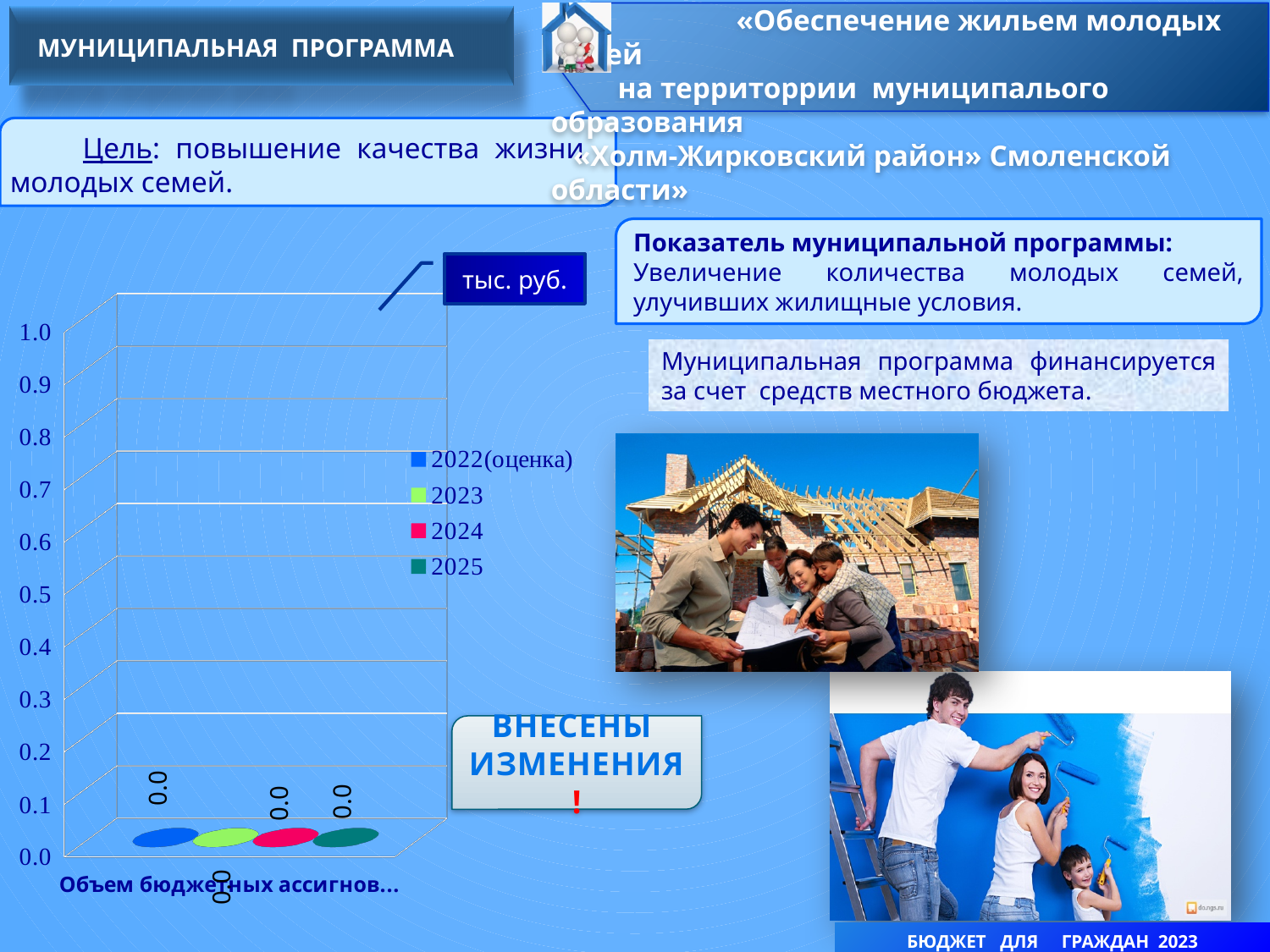
Is the value for the 2024 series greater or less than 0.5? less Which legend entry is marked as an estimate (оценка)? 2022(оценка) What is the value for the 2023 series in the chart? 0.0 What is the value for the 2022(оценка) series in the chart? 0.0 How many categories are shown on the x axis of the chart? 1 How many series does the chart legend list? 4 What unit of measurement is indicated for the chart? тыс. руб. What is the highest value shown on the chart's vertical axis? 1.0 What is the value for the 2025 series in the chart? 0.0 What is the value for the 2024 series in the chart? 0.0 What kind of chart is shown on the slide? bar chart What is the difference between the 2023 value and the 2025 value in the chart? 0.0